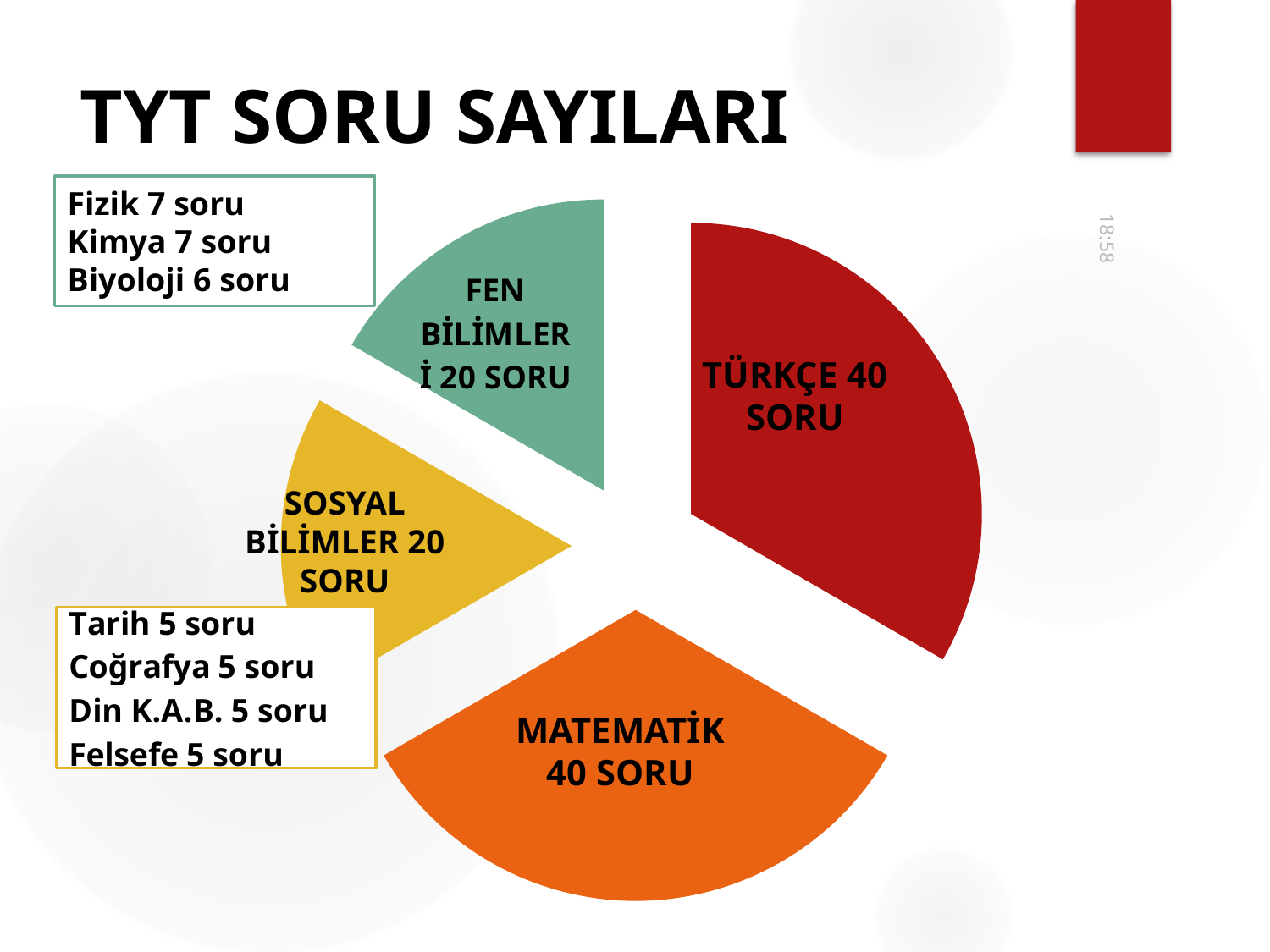
How many questions (soru) does the Türkçe slice show? 40 How many questions (soru) does the Matematik slice show? 40 How many slices does the pie chart have? 4 What is the title of the slide containing the chart? TYT SORU SAYILARI What share of the total questions does the Türkçe slice represent? one third How many questions (soru) does the Fen Bilimleri slice show? 20 How many questions (soru) does the Sosyal Bilimler slice show? 20 Which slice is larger, Türkçe or Sosyal Bilimler? Türkçe What is the total number of questions across all four slices of the pie chart? 120 What kind of chart is shown on the slide? pie chart What colour is the Matematik slice of the pie chart? orange What is the difference in question count between Matematik and Fen Bilimleri? 20